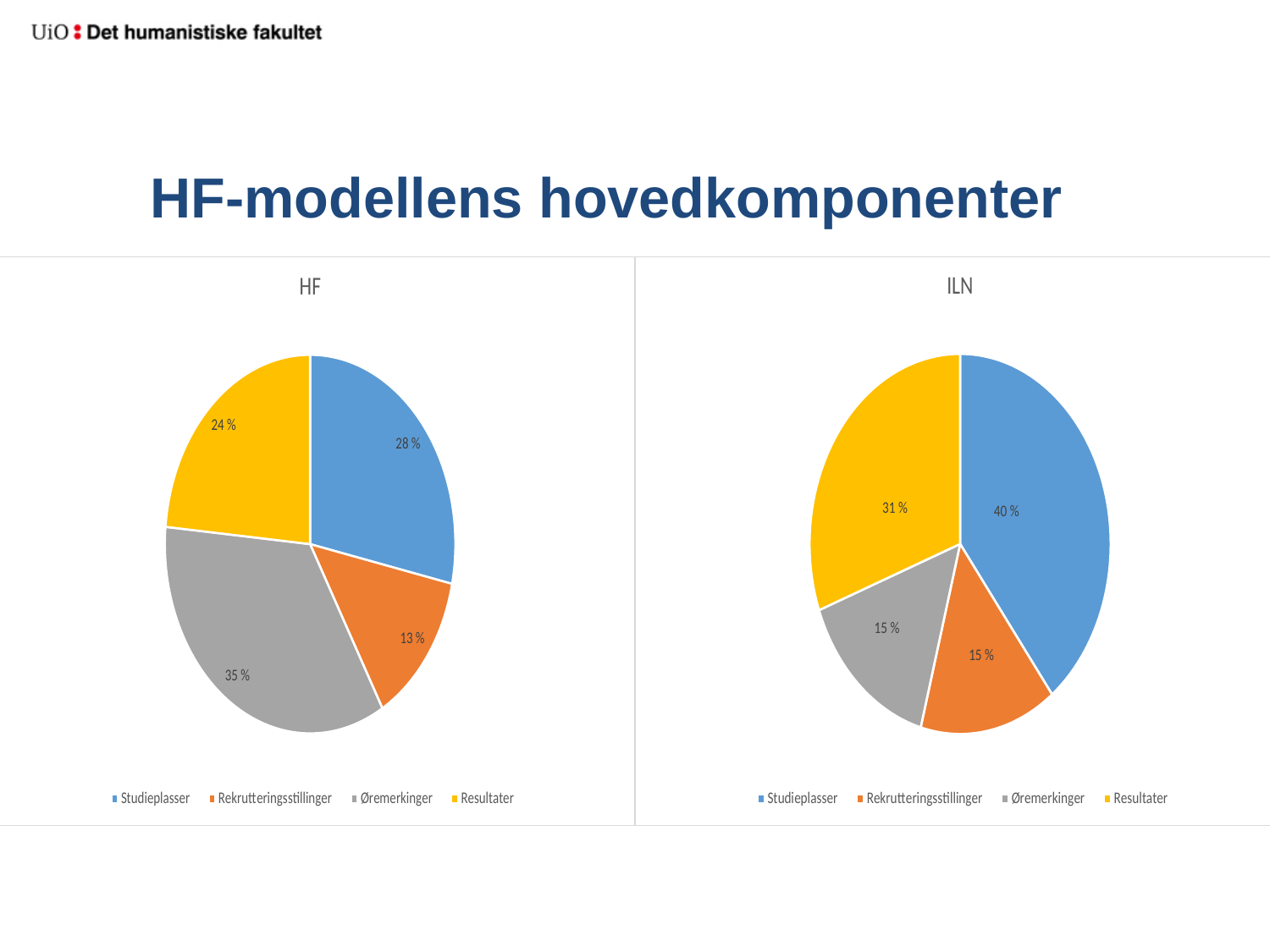
In the ILN pie chart, what is the difference between the shares for Studieplasser and Resultater? 9 % In the HF pie chart, what is the difference between the shares for Øremerkinger and Rekrutteringsstillinger? 22 % What type of chart is the ILN chart? Pie chart Which is larger: the share for Resultater in the HF chart or in the ILN chart? ILN In the HF pie chart, which category has the largest slice? Øremerkinger In the HF pie chart, what is the share for Studieplasser? 28 % In the ILN pie chart, what is the share for Studieplasser? 40 % How many slices does the HF pie chart have? 4 In the HF pie chart, what is the share for Øremerkinger? 35 % In the ILN pie chart, which category has the largest slice? Studieplasser In the ILN pie chart, what is the share for Resultater? 31 % In the HF pie chart, which category has the smallest slice? Rekrutteringsstillinger